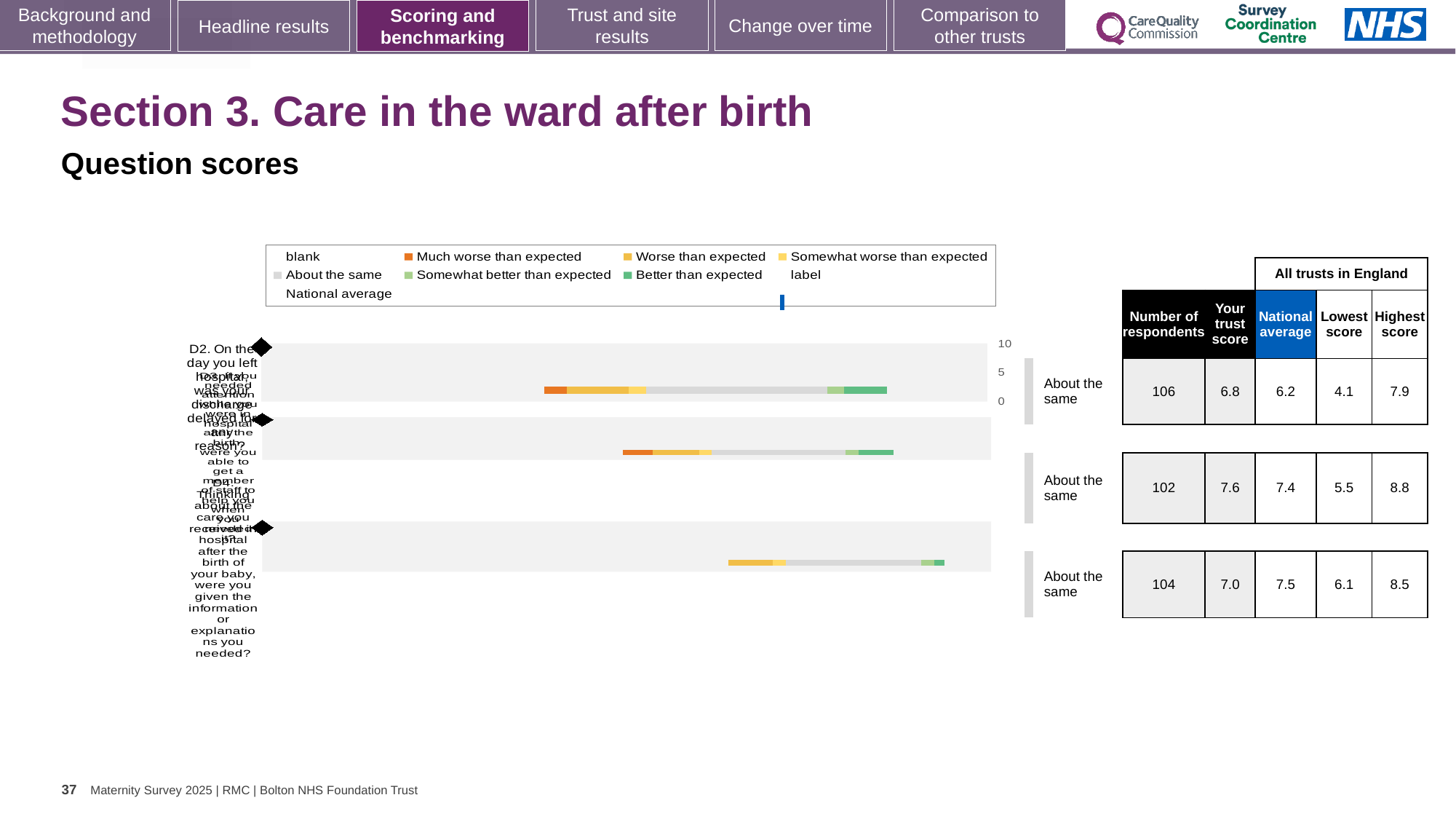
Which row of the table has the highest 'Highest score' value? the middle row (8.8) For the top row of the table, which is larger: the trust score or the national average? the trust score (6.8) In the table next to the chart, what is the number of respondents for the bottom row? 104 In the table next to the chart, what is the national average for the bottom row? 7.5 For the bottom row of the table, what is the difference between the highest score and the lowest score? 2.4 In the table next to the chart, what is the number of respondents for the top row? 106 In the table next to the chart, what is the 'Your trust score' value for the middle row? 7.6 What kind of chart is shown on the slide? bar chart What colour does the legend use for 'Much worse than expected'? orange What comparison category is shown beside each of the three bars? About the same Which row of the table has the lowest 'Lowest score' value? the top row (4.1) How many question bars are plotted in the chart? 3